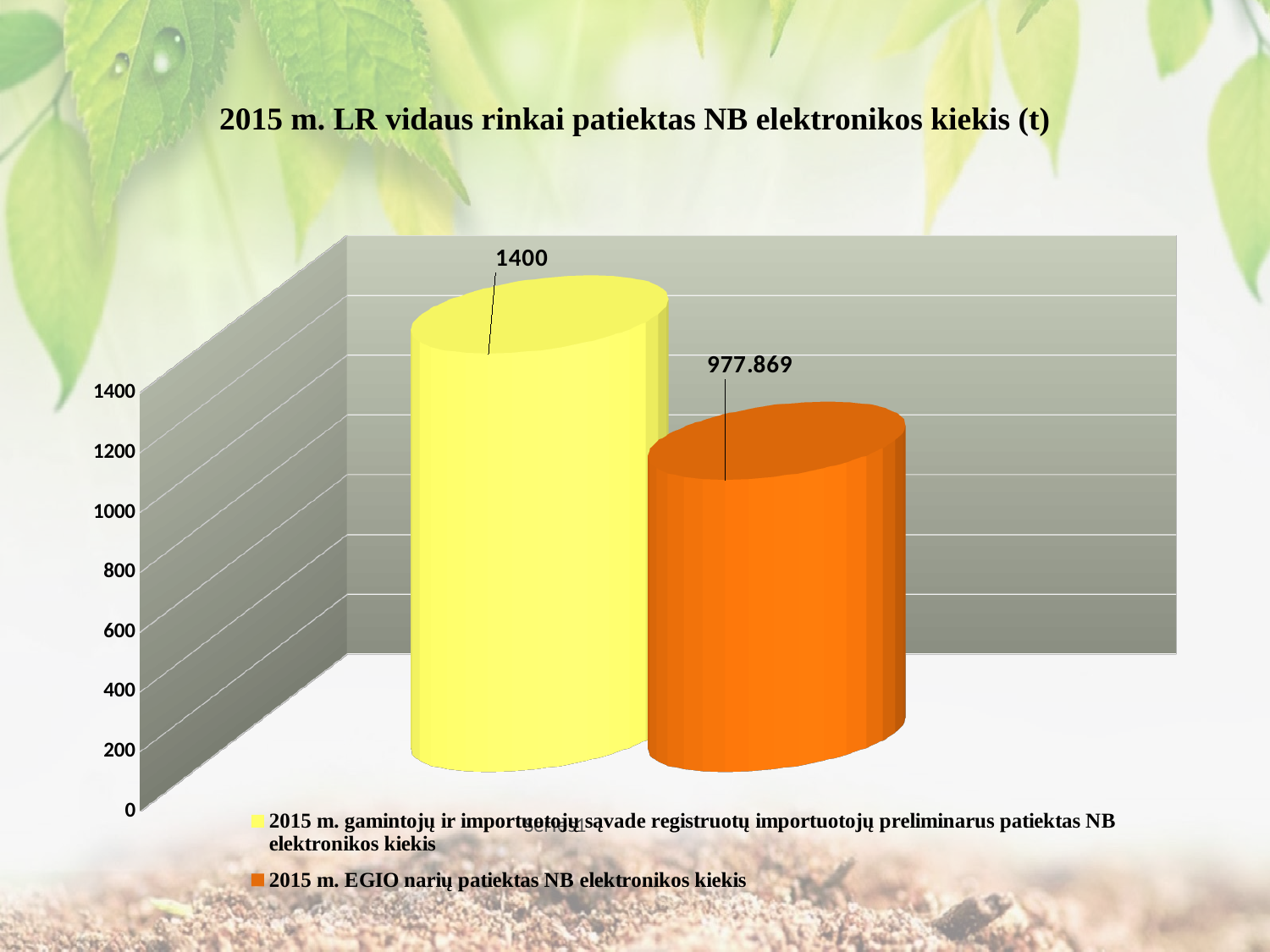
What is the value for the series '2015 m. EGIO narių patiektas NB elektronikos kiekis'? 977.869 What is the difference between the yellow bar value and the orange bar value? 422.131 How many series does the legend list? 2 Which series has the lower value? 2015 m. EGIO narių patiektas NB elektronikos kiekis Is the yellow bar's value larger or smaller than the orange bar's value? larger What kind of chart is shown on the slide? bar chart Which series has the higher value? 2015 m. gamintojų ir importuotojų sąvade registruotų importuotojų preliminarus patiektas NB elektronikos kiekis What is the title of the chart? 2015 m. LR vidaus rinkai patiektas NB elektronikos kiekis (t) Is the value for '2015 m. EGIO narių patiektas NB elektronikos kiekis' greater or less than 1000? less What is the value shown by the yellow bar? 1400 What is the value shown by the orange bar? 977.869 What is the value for the series '2015 m. gamintojų ir importuotojų sąvade registruotų importuotojų preliminarus patiektas NB elektronikos kiekis'? 1400